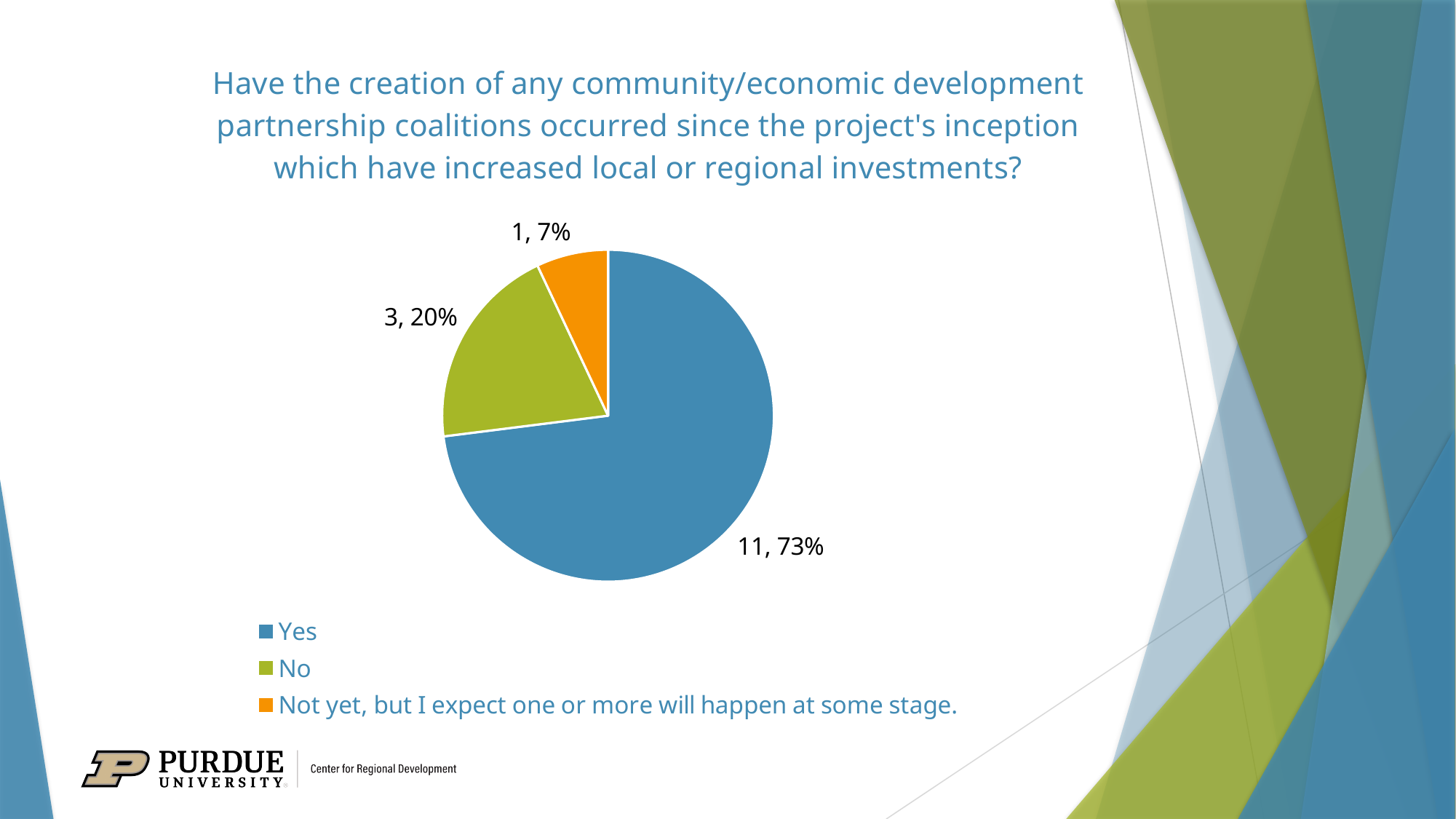
Which category has the smallest slice of the pie? Not yet, but I expect one or more will happen at some stage. Which has more respondents, "No" or "Not yet, but I expect one or more will happen at some stage."? No What kind of chart is shown on the slide? pie chart Which category has the largest slice of the pie? Yes How many respondents answered "Yes"? 11 How many more respondents answered "Yes" than "No"? 8 What share of the pie does the "Yes" slice represent? 73% What percentage of the pie does the "No" slice represent? 20% What colour is the "No" slice in the pie chart? green How many categories does the pie chart have? 3 What is the total number of respondents across all slices of the pie? 15 How many respondents answered "Not yet, but I expect one or more will happen at some stage."? 1